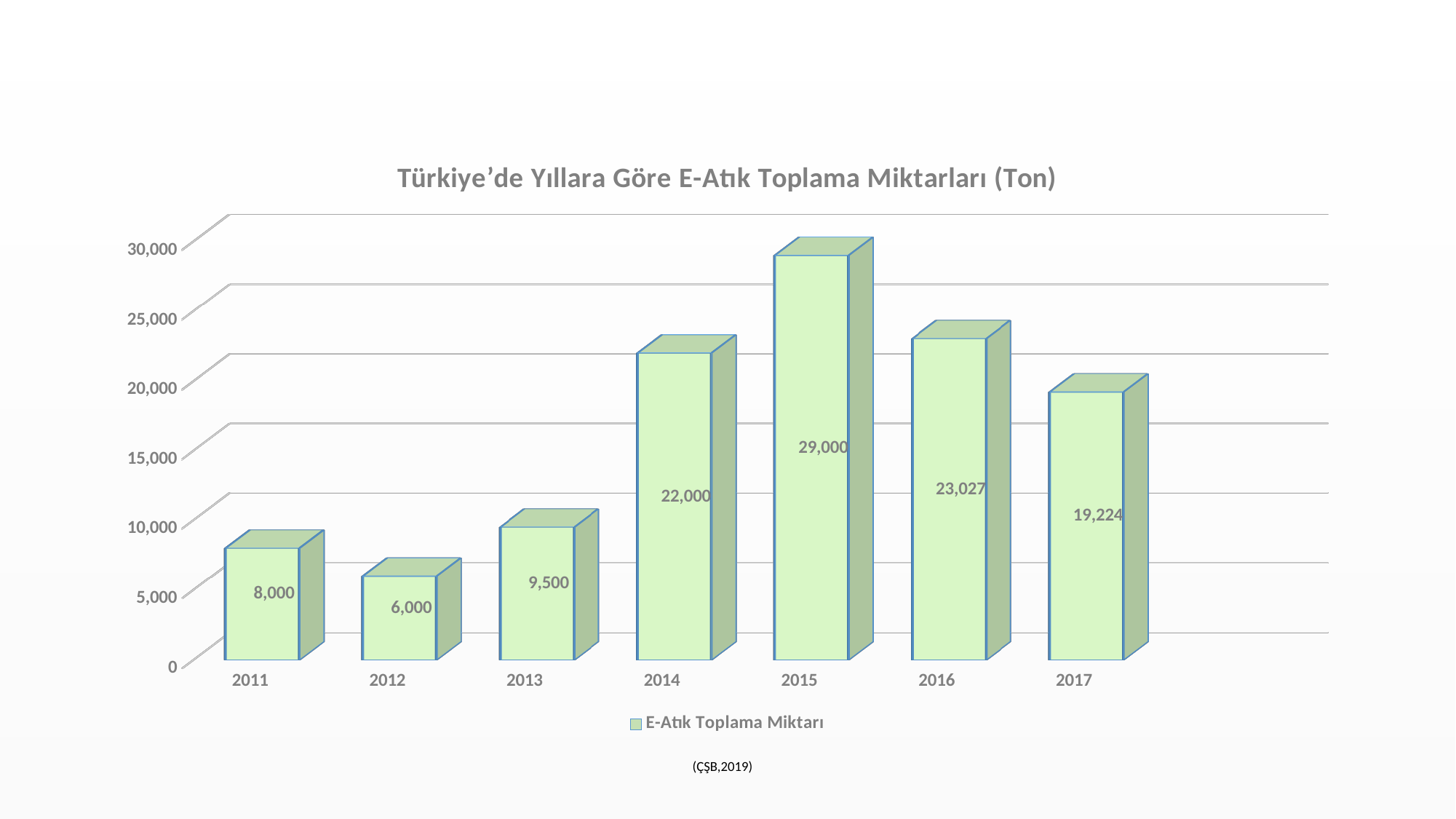
What is the e-waste collection amount for 2015? 29,000 What is the e-waste collection amount for 2017? 19,224 How many years are shown on the x axis? 7 Which year has a larger e-waste collection amount, 2011 or 2013? 2013 Which year has the highest e-waste collection amount? 2015 What is the e-waste collection amount for 2012? 6,000 Is the value for 2014 greater or less than 20,000? greater What is the difference between the e-waste collection amounts for 2014 and 2013? 12,500 What is the title of the chart? Türkiye'de Yıllara Göre E-Atık Toplama Miktarları (Ton) Which year has the lowest e-waste collection amount? 2012 What kind of chart is shown on the slide? Bar chart What is the difference between the e-waste collection amounts for 2016 and 2017? 3,803